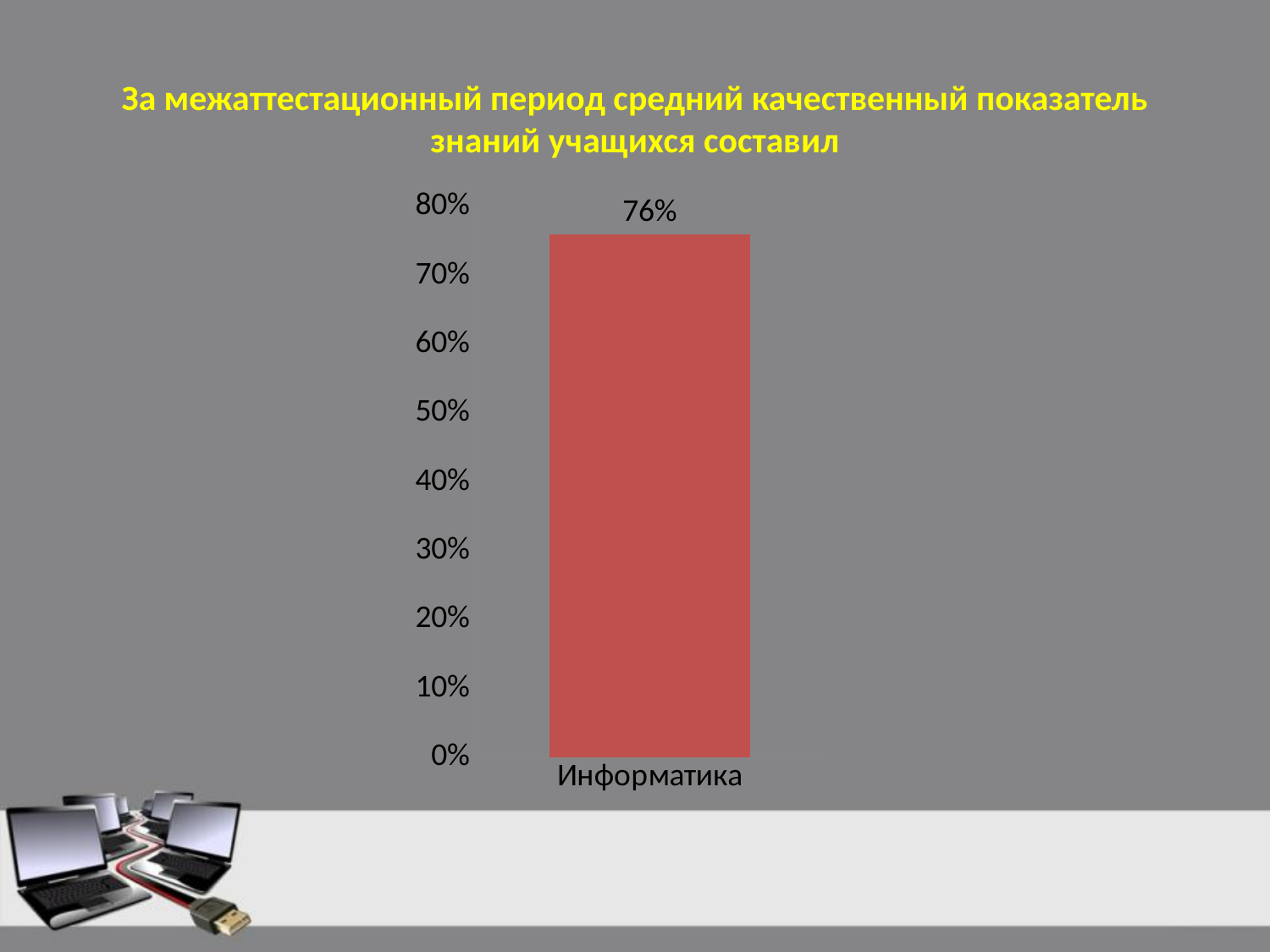
What is the value shown for Информатика? 76% What is the highest value shown on the vertical axis? 80% What kind of chart is shown on the slide? bar chart Is the value for Информатика greater or less than 80%? less What is the label of the single category on the x axis? Информатика Is the value for Информатика greater or less than 70%? greater How many categories are plotted in the chart? 1